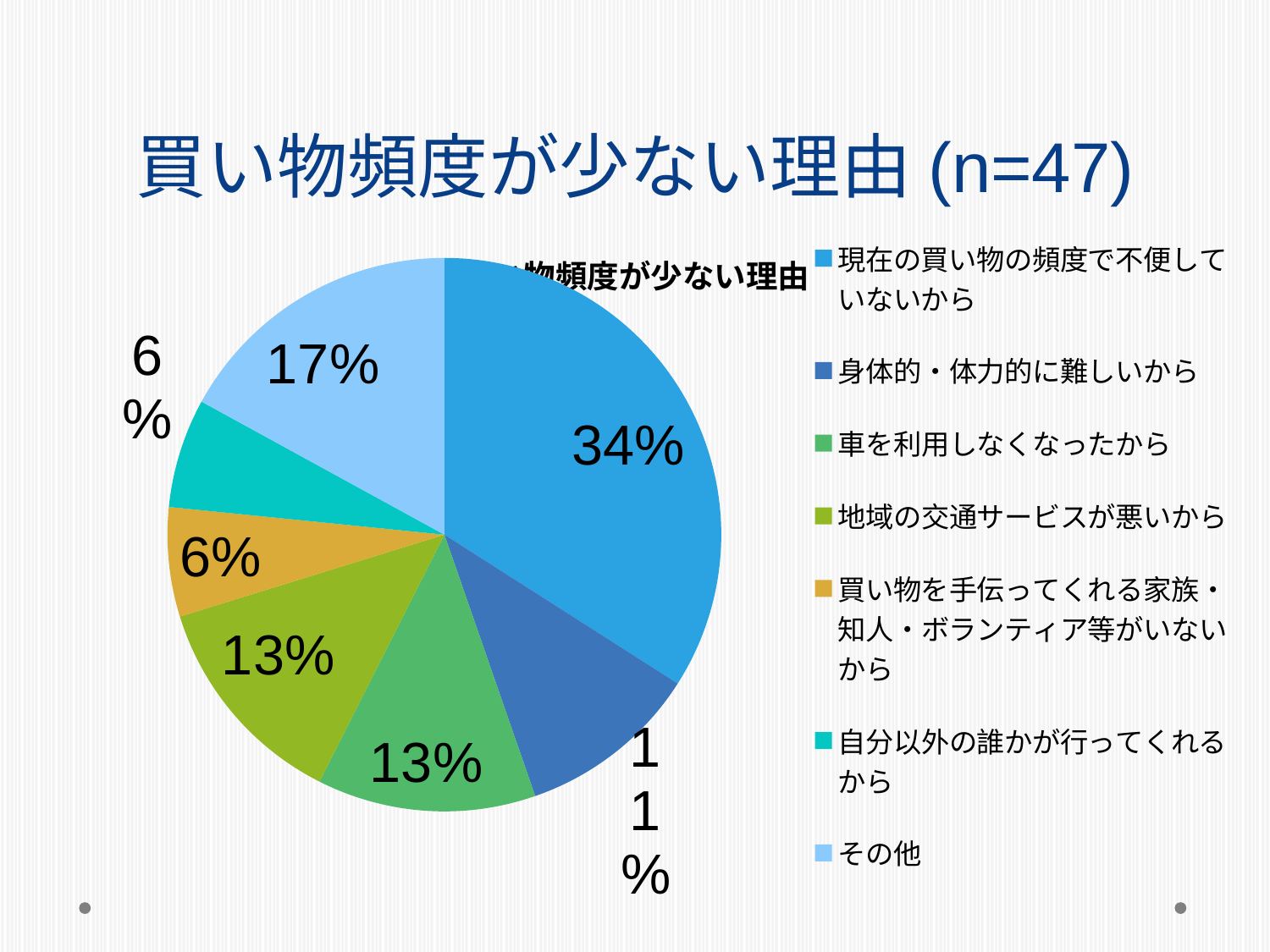
What is the sample size (n) given in the slide title? 47 What is the title of the slide? 買い物頻度が少ない理由 (n=47) What is the difference in percentage points between 現在の買い物の頻度で不便していないから and その他? 17 How many categories does the legend list? 7 Which category has the largest share of the pie? 現在の買い物の頻度で不便していないから What percentage is shown for 車を利用しなくなったから? 13% What percentage is shown for その他? 17% What percentage of the pie is the slice for 現在の買い物の頻度で不便していないから? 34% What kind of chart is shown on the slide? pie chart Which is larger, the share for 地域の交通サービスが悪いから or the share for 買い物を手伝ってくれる家族・知人・ボランティア等がいないから? 地域の交通サービスが悪いから What percentage is shown for 身体的・体力的に難しいから? 11% What percentage is shown for 自分以外の誰かが行ってくれるから? 6%